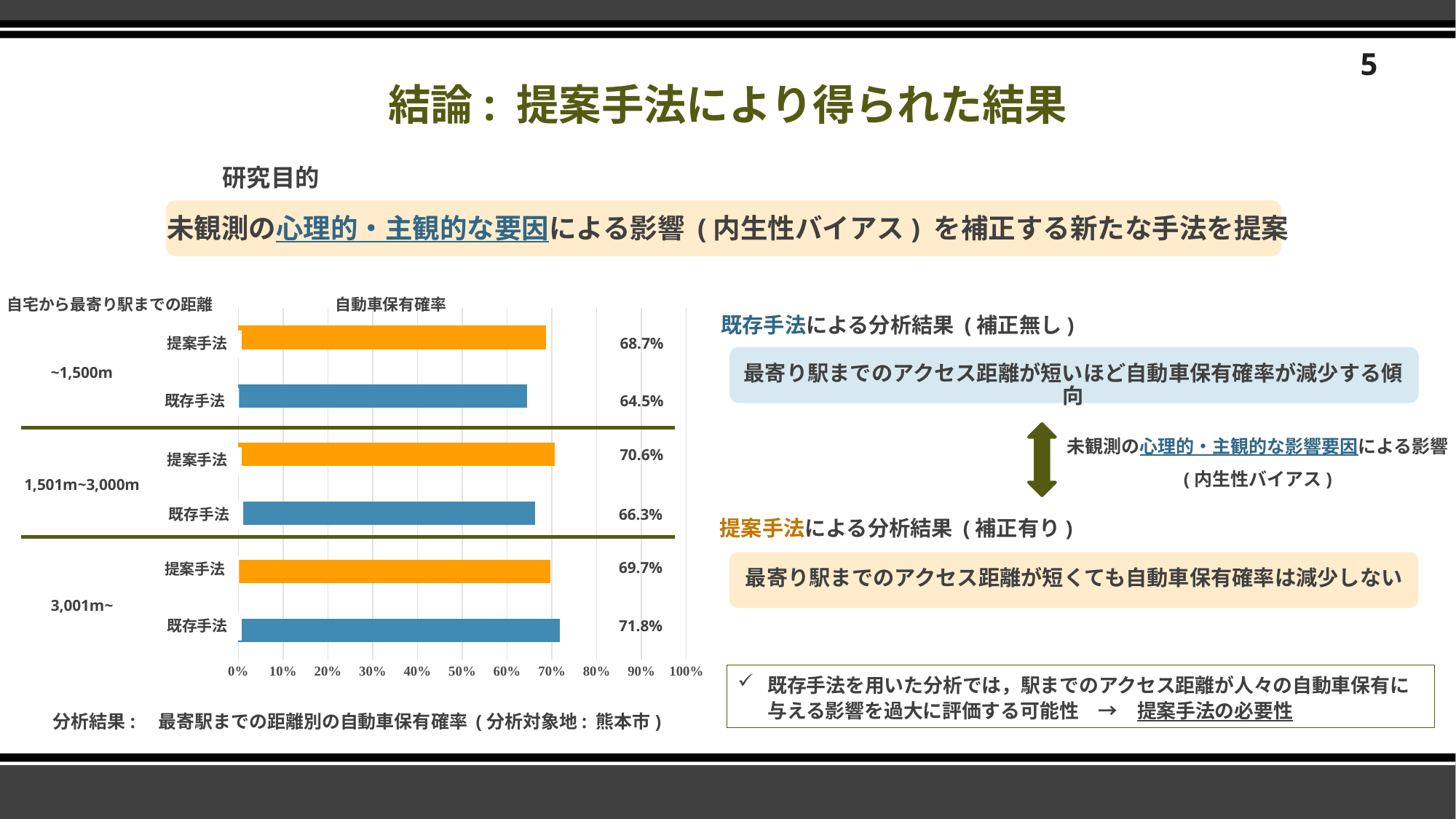
Is the value for 既存手法 in the ~1,500m group greater or less than 70%? less What is the 自動車保有確率 for 提案手法 in the ~1,500m group? 68.7% How many bars are plotted in the chart? 6 What is the 自動車保有確率 for 既存手法 in the ~1,500m group? 64.5% In the 3,001m~ group, which is larger: 提案手法 or 既存手法? 既存手法 What is the 自動車保有確率 for 既存手法 in the 3,001m~ group? 71.8% What is the 自動車保有確率 for 提案手法 in the 1,501m~3,000m group? 70.6% What is the difference between 提案手法 and 既存手法 in the ~1,500m group? 4.2% Which bar in the chart has the lowest 自動車保有確率? 既存手法, ~1,500m (64.5%) Which bar in the chart has the highest 自動車保有確率? 既存手法, 3,001m~ (71.8%) What is the difference between 提案手法 and 既存手法 in the 1,501m~3,000m group? 4.3% What kind of chart is shown on the slide? Bar chart